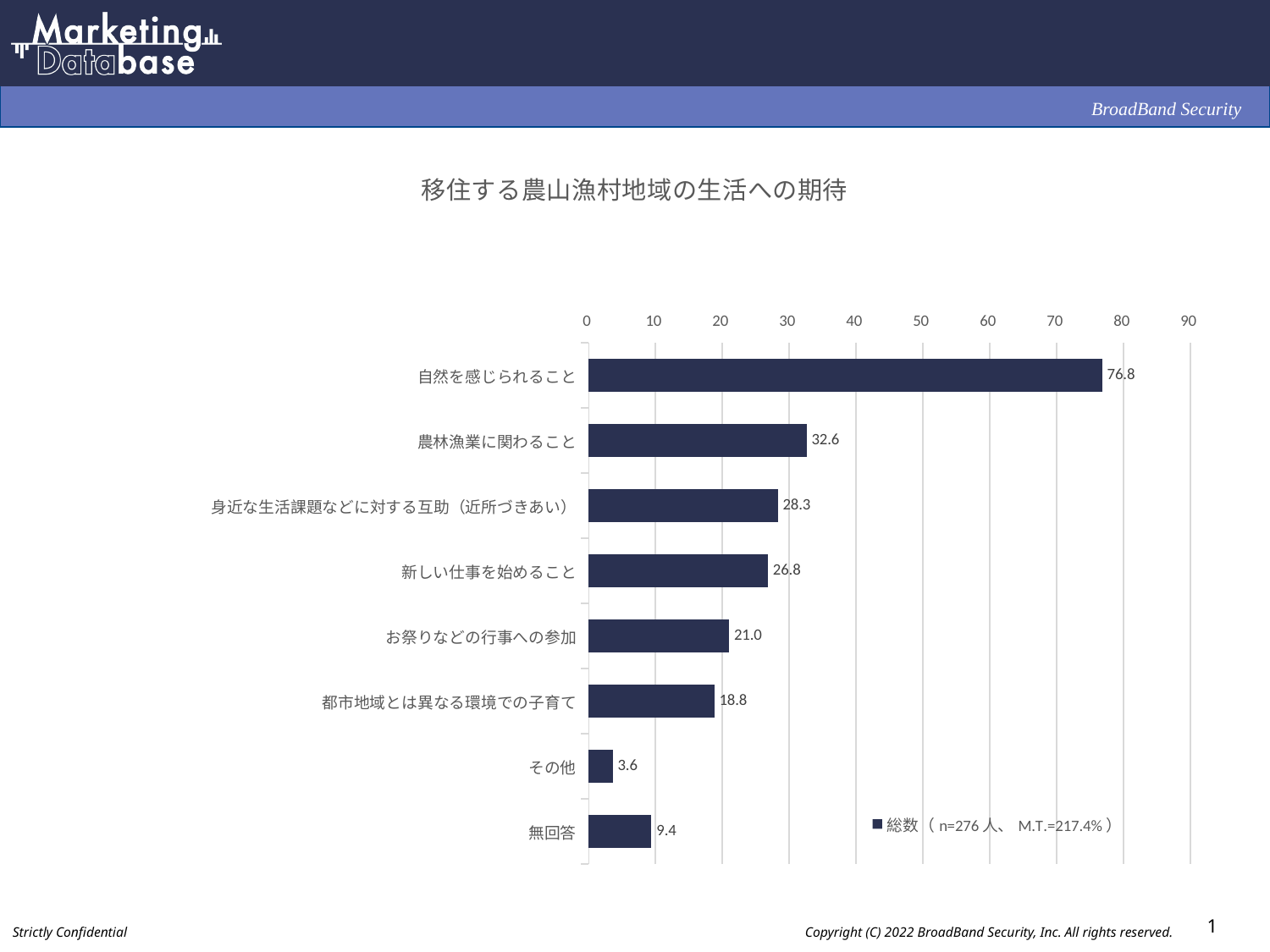
Which category has the lowest value? その他 What is the value for 都市地域とは異なる環境での子育て? 18.8 What is the value for 自然を感じられること? 76.8 What is the title of the chart? 移住する農山漁村地域の生活への期待 Which is larger, the value for 新しい仕事を始めること or お祭りなどの行事への参加? 新しい仕事を始めること What kind of chart is shown on the slide? bar chart What is the value for 農林漁業に関わること? 32.6 How many series does the legend list? 1 Is the value for 身近な生活課題などに対する互助（近所づきあい） greater or less than 30? less What is the difference between the values for 自然を感じられること and 農林漁業に関わること? 44.2 Which category has the highest value? 自然を感じられること How many categories are shown in the chart? 8